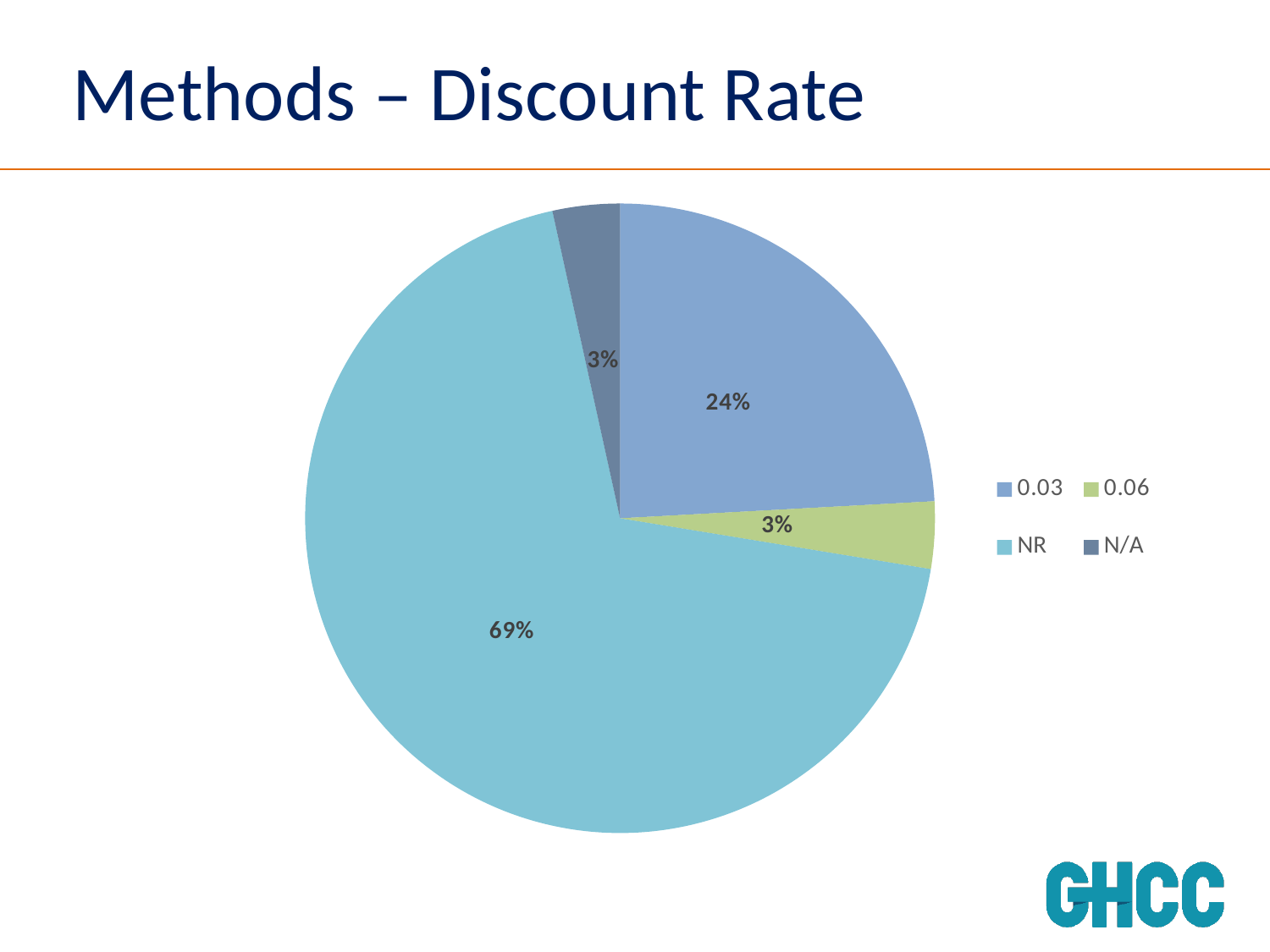
What share of the pie does the N/A slice represent? 3% Which category has the largest slice of the pie? NR What is the difference in percentage points between the NR slice and the 0.03 slice? 45 What is the combined share of the 0.03 and 0.06 slices? 27% What kind of chart is shown on the slide? Pie chart What share of the pie does the NR slice represent? 69% What share of the pie does the 0.06 slice represent? 3% What is the title of the slide containing the chart? Methods – Discount Rate Which legend entries are listed for the pie chart? 0.03, 0.06, NR, N/A Which slice is larger, 0.03 or 0.06? 0.03 How many categories does the pie chart show? 4